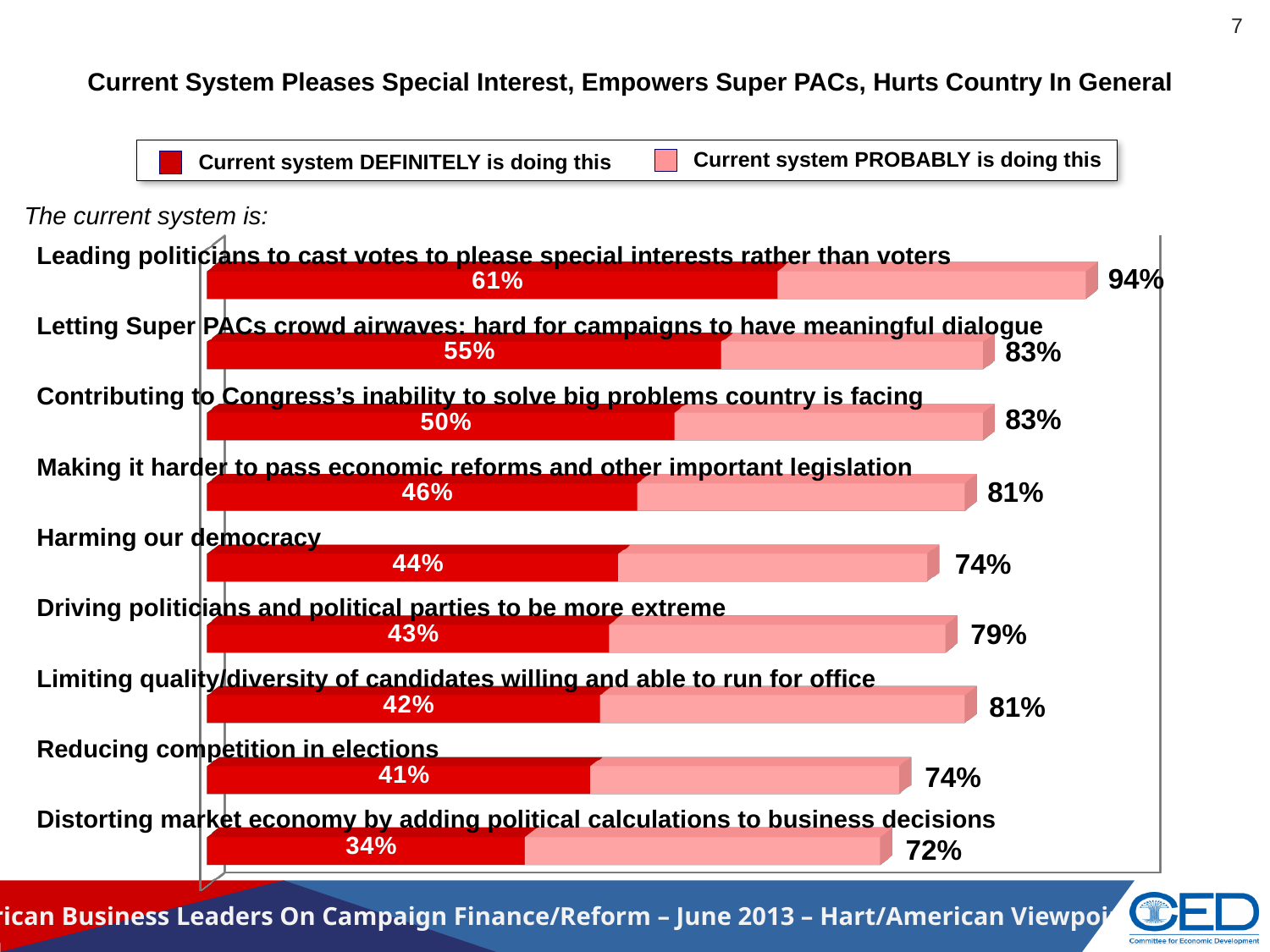
What is the combined (definitely plus probably) percentage for 'Leading politicians to cast votes to please special interests rather than voters'? 94% What kind of chart is shown on the slide? Bar chart How many series does the legend list? 2 How many statements (categories) are plotted in the chart? 9 Which statement has the lowest 'DEFINITELY is doing this' percentage? Distorting market economy by adding political calculations to business decisions What are the two legend entries in the chart? Current system DEFINITELY is doing this; Current system PROBABLY is doing this What percentage say the current system DEFINITELY is 'Driving politicians and political parties to be more extreme'? 43% What is the difference in the DEFINITELY percentage between 'Leading politicians to cast votes to please special interests rather than voters' and 'Letting Super PACs crowd airwaves'? 6 percentage points What percentage say the current system DEFINITELY is 'Harming our democracy'? 44% What is the combined percentage shown at the end of the bar for 'Reducing competition in elections'? 74% Which statement has the highest 'DEFINITELY is doing this' percentage? Leading politicians to cast votes to please special interests rather than voters Which has a higher DEFINITELY percentage: 'Harming our democracy' or 'Reducing competition in elections'? Harming our democracy